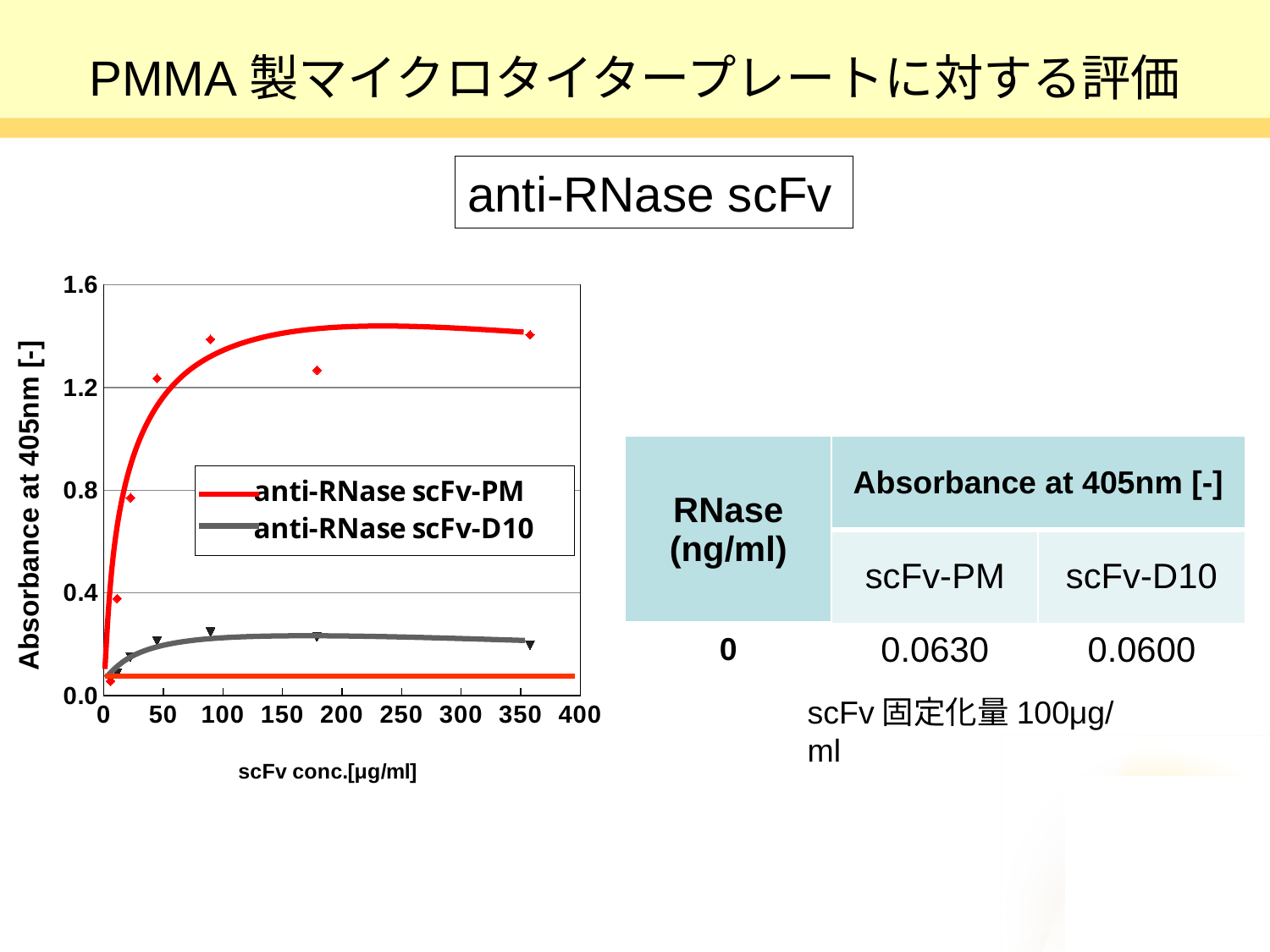
Which series has the higher absorbance at a scFv concentration of 350 µg/ml, anti-RNase scFv-PM or anti-RNase scFv-D10? anti-RNase scFv-PM Does the absorbance for anti-RNase scFv-PM rise or fall as the scFv concentration increases from 0 to 100 µg/ml? rise What kind of chart is shown on the slide? line chart What is the label of the chart's y axis? Absorbance at 405nm [-] Is the value for anti-RNase scFv-PM at a scFv concentration of 50 µg/ml greater or less than 0.8? greater Which series has the lower absorbance across the whole concentration range? anti-RNase scFv-D10 What are the two series named in the chart legend? anti-RNase scFv-PM and anti-RNase scFv-D10 Is the value for anti-RNase scFv-PM at a scFv concentration of 350 µg/ml greater or less than 1.2? greater Is the value for anti-RNase scFv-D10 at a scFv concentration of 350 µg/ml greater or less than 0.4? less How many series does the chart legend list? 2 Which series reaches the highest absorbance in the chart? anti-RNase scFv-PM